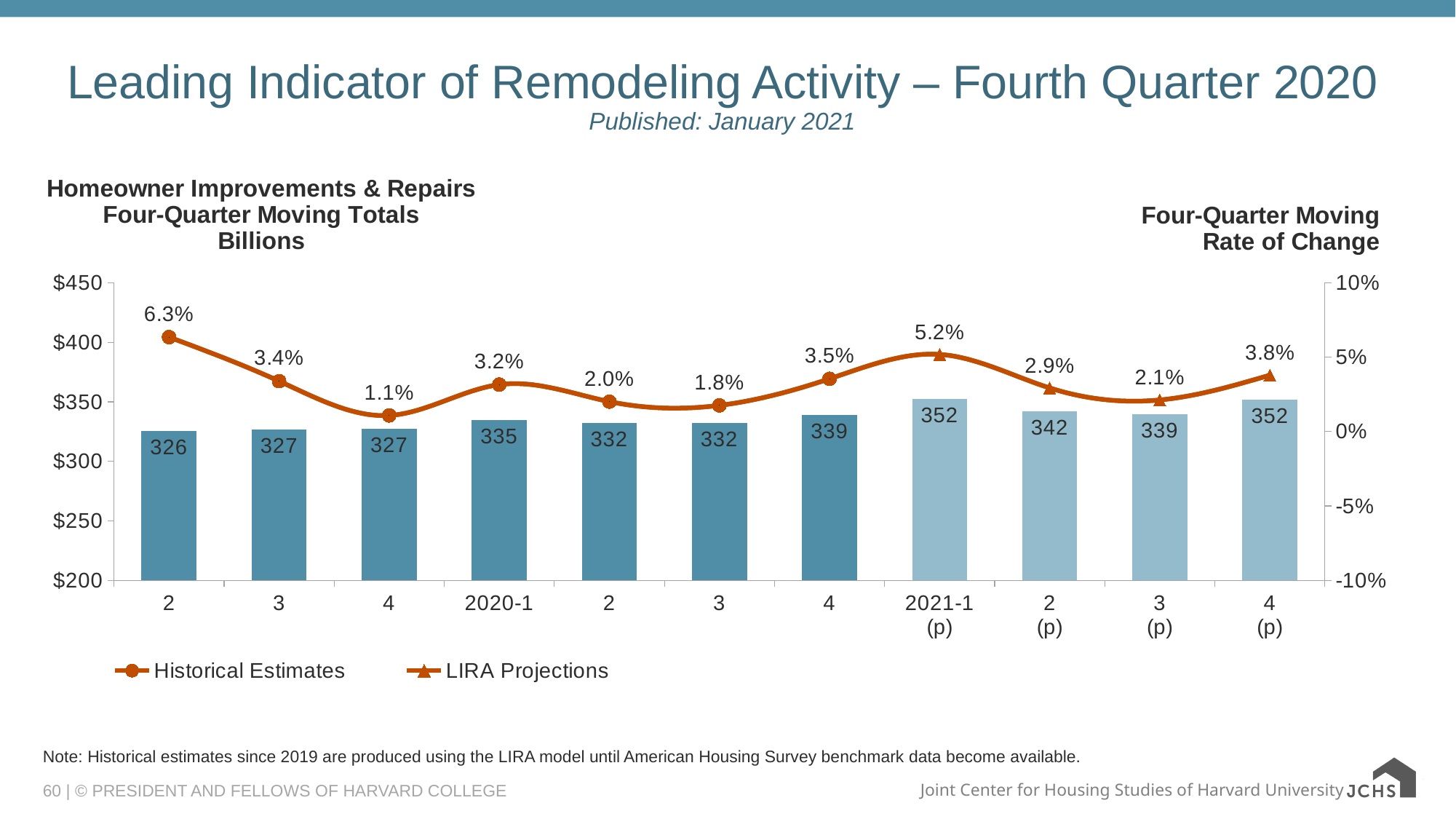
What is the four-quarter moving rate of change for 2021-1 (p)? 5.2% Is the four-quarter moving total larger for 2020-4 or for 2021-2 (p)? 2021-2 (p) How many quarters (categories) are shown on the x axis? 11 How many series does the legend list? 2 Which category has the lowest four-quarter moving rate of change? 4 (2019) Which category has the highest four-quarter moving rate of change? 2 (2019) What kind of chart is this? Combination bar and line chart Does the four-quarter moving rate of change rise or fall from 2020-1 to 2020-3? Fall What is the four-quarter moving total (in billions) for 2020-1? 335 What is the four-quarter moving rate of change for the first category, quarter 2 (of 2019)? 6.3% What are the two entries listed in the legend? Historical Estimates and LIRA Projections What is the difference between the four-quarter moving total for 2021-1 (p) and for 2020-1? 17